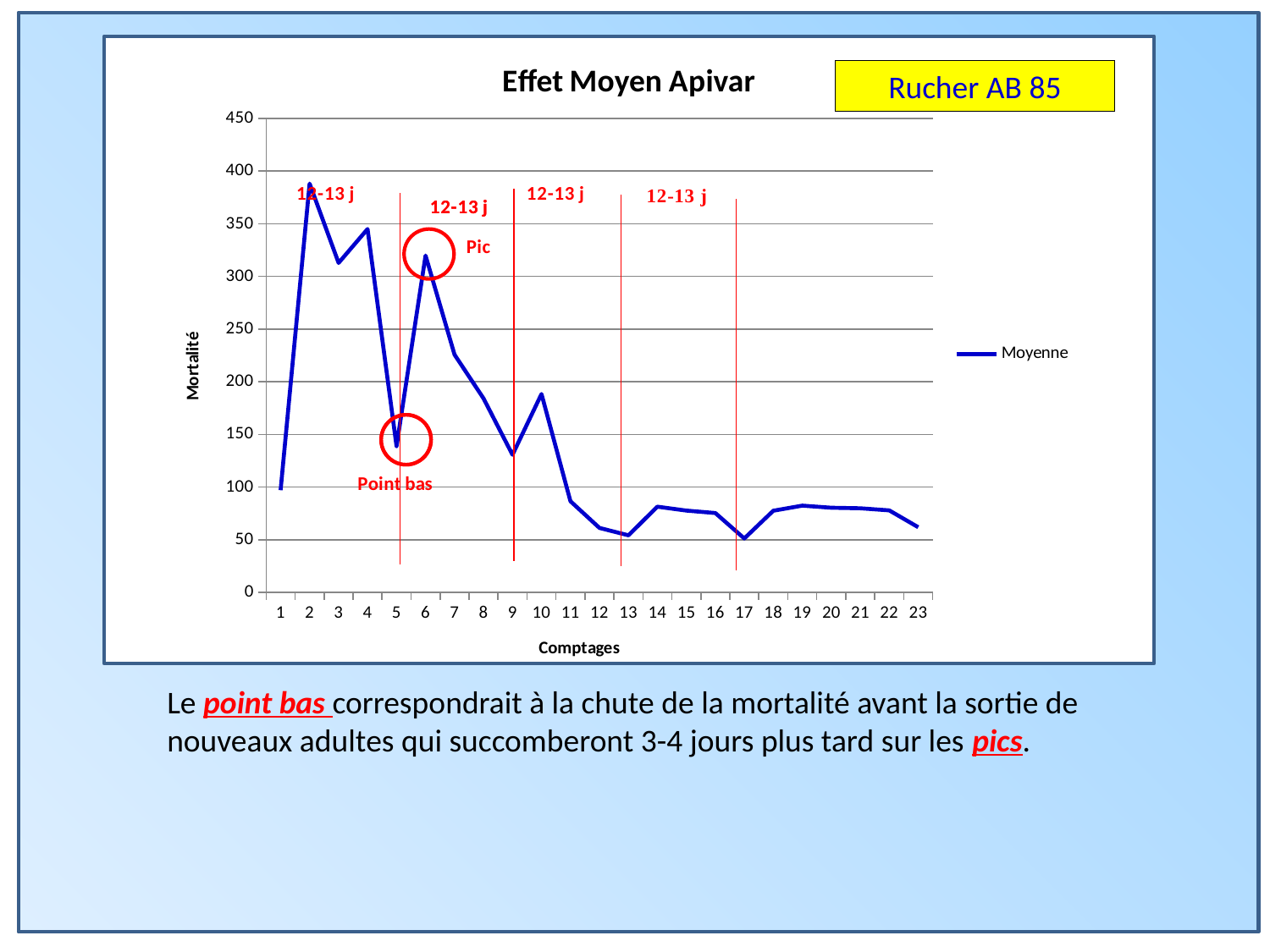
What is the name of the series shown in the legend? Moyenne At which comptage is the Moyenne value highest? 2 What kind of chart is shown on the slide? line chart What is the title of the chart? Effet Moyen Apivar Is the Moyenne value at comptage 5 greater or less than 200? less How many comptages (points) are plotted along the x axis? 23 Is the Moyenne value at comptage 2 greater or less than 350? greater Is the Moyenne value at comptage 6 greater or less than 300? greater Which has the larger Moyenne value, comptage 4 or comptage 6? comptage 4 How many series does the legend list? 1 Does the Moyenne value rise or fall from comptage 10 to comptage 12? fall